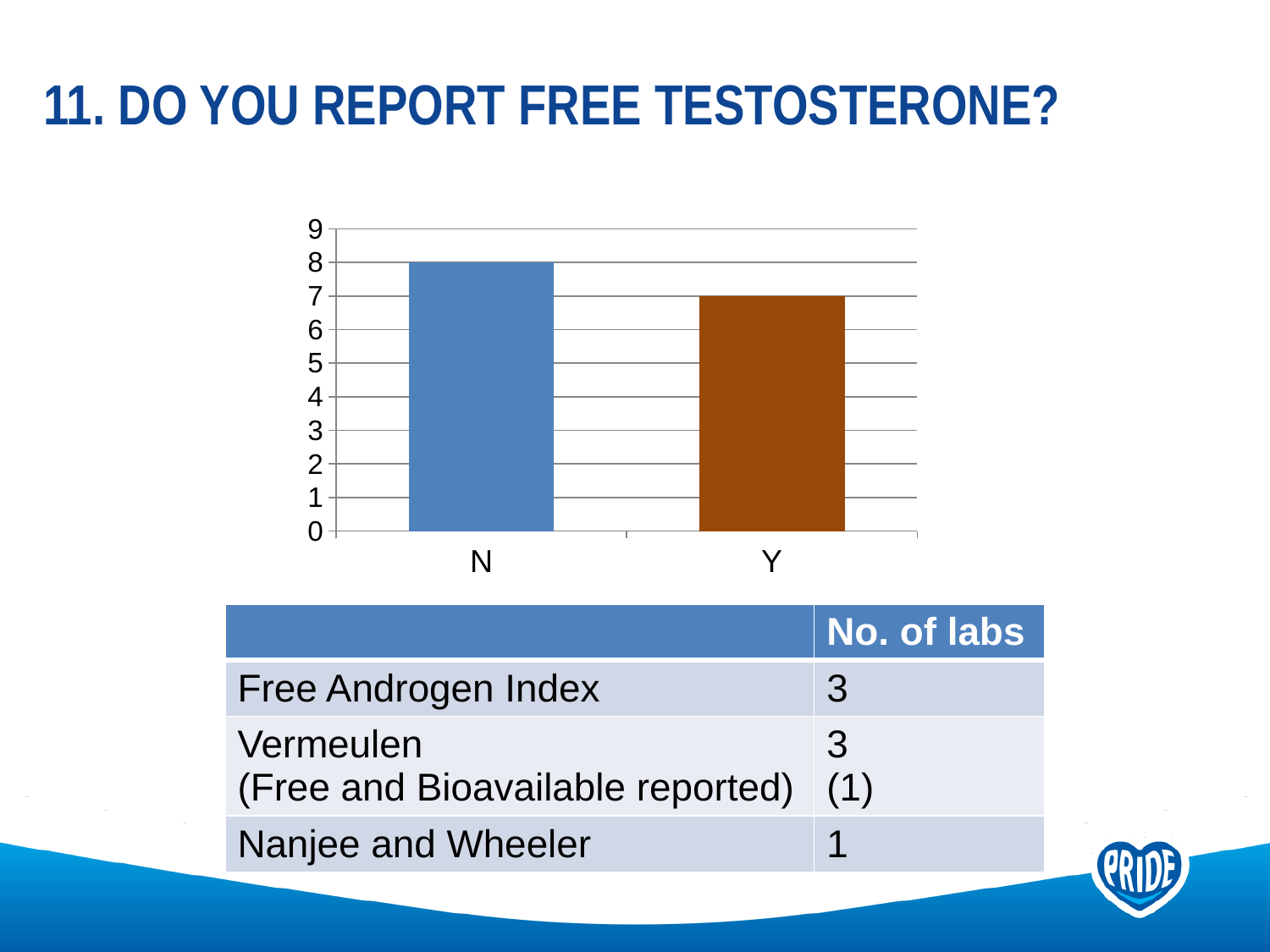
What colour is the bar for Y? brown What is the value for Y in the chart? 7 What is the value for N in the chart? 8 Which is larger, the value for N or the value for Y? N What type of chart is shown on the slide? bar chart Is the value for N greater or less than 9? less Is the value for Y greater or less than 5? greater What is the difference between the values for N and Y? 1 How many categories are shown on the x axis of the chart? 2 Which category has the highest value in the chart? N Which category has the lowest value in the chart? Y What is the maximum value shown on the y axis of the chart? 9